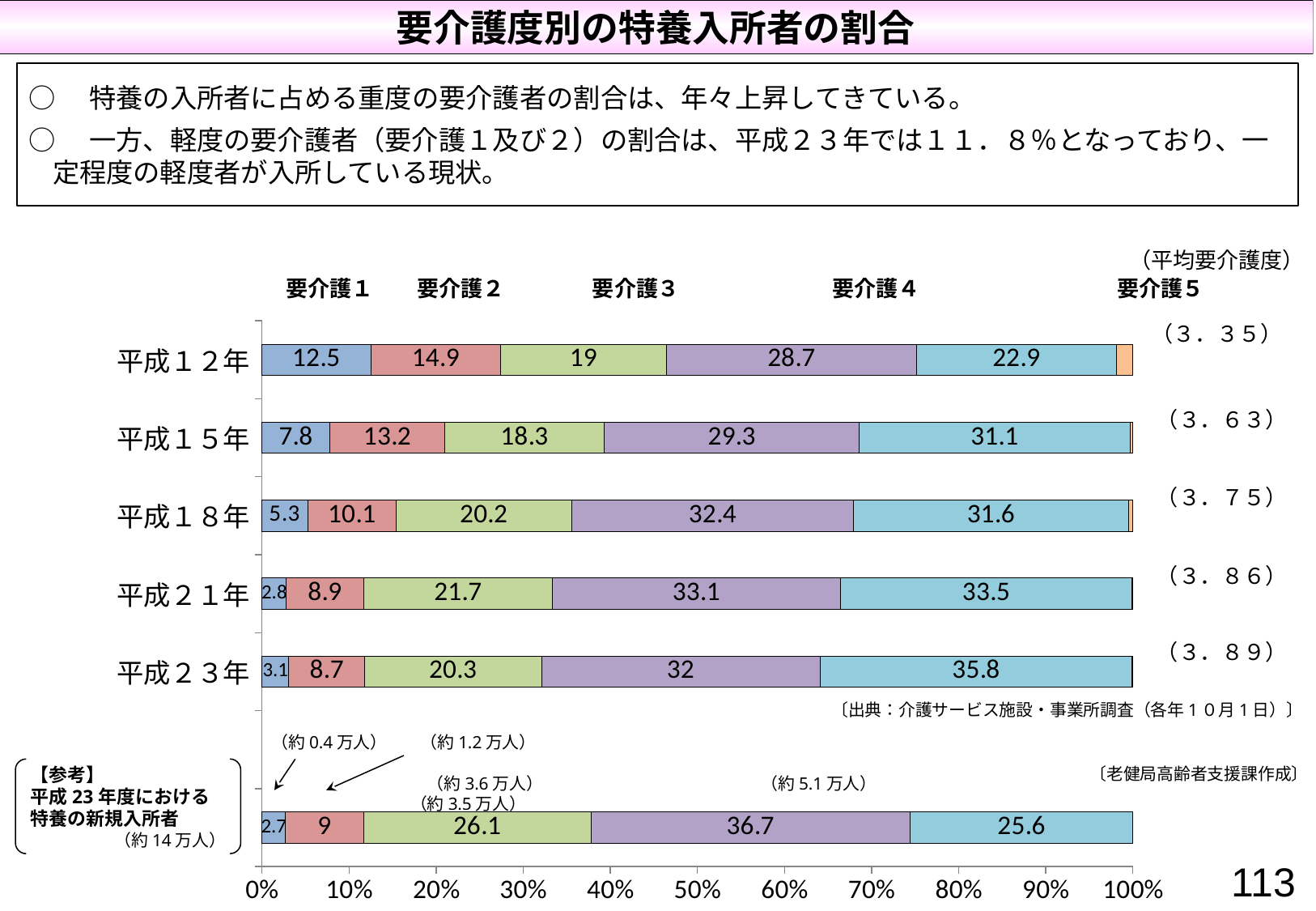
What kind of chart is shown on the slide? stacked bar chart Does the 要介護1 share rise or fall from 平成12年 to 平成23年? fall Among the five 平成 years, which year has the lowest 要介護1 value? 平成21年 What is the combined value of 要介護1 and 要介護2 in the 平成23年 bar? 11.8 What is the difference between the 要介護4 value for 平成23年 and for 平成12年? 3.3 Among the five 平成 years, which year has the highest 要介護5 value? 平成23年 What is the value for 要介護4 in the bottom reference bar (平成23年度 新規入所者)? 36.7 What is the value for 要介護1 in the 平成12年 bar? 12.5 How many 平成 years are shown as bars in the chart (excluding the reference bar)? 5 Does the 要介護5 share rise or fall from 平成12年 to 平成23年? rise What is the value for 要介護5 in the 平成23年 bar? 35.8 Which is larger, the 要介護3 value for 平成18年 or for 平成21年? 平成21年